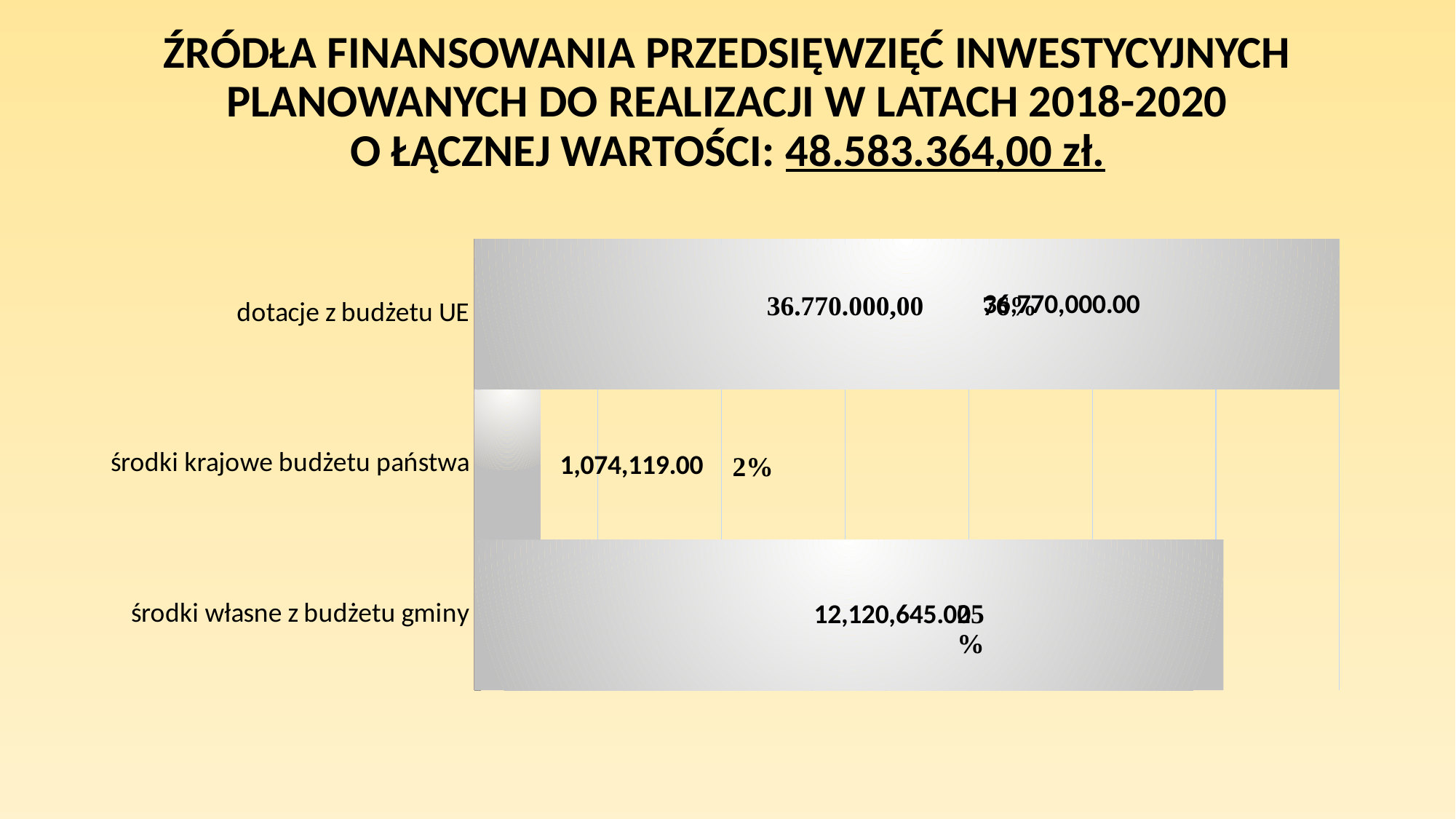
What kind of chart is shown on the slide? bar chart What is the difference between the value for środki własne z budżetu gminy and the value for środki krajowe budżetu państwa? 11,046,526.00 According to the slide title, what is the total value of the planned investment projects for 2018-2020? 48.583.364,00 zł What is the value for dotacje z budżetu UE? 36,770,000.00 Which funding source has the highest value? dotacje z budżetu UE How many categories (funding sources) does the chart show? 3 Which funding source has the lowest value? środki krajowe budżetu państwa What is the value for środki krajowe budżetu państwa? 1,074,119.00 Which is larger: środki własne z budżetu gminy or środki krajowe budżetu państwa? środki własne z budżetu gminy What is the value for środki własne z budżetu gminy? 12,120,645.00 What is the difference between the value for dotacje z budżetu UE and the value for środki własne z budżetu gminy? 24,649,355.00 What percentage share is shown for środki krajowe budżetu państwa? 2%